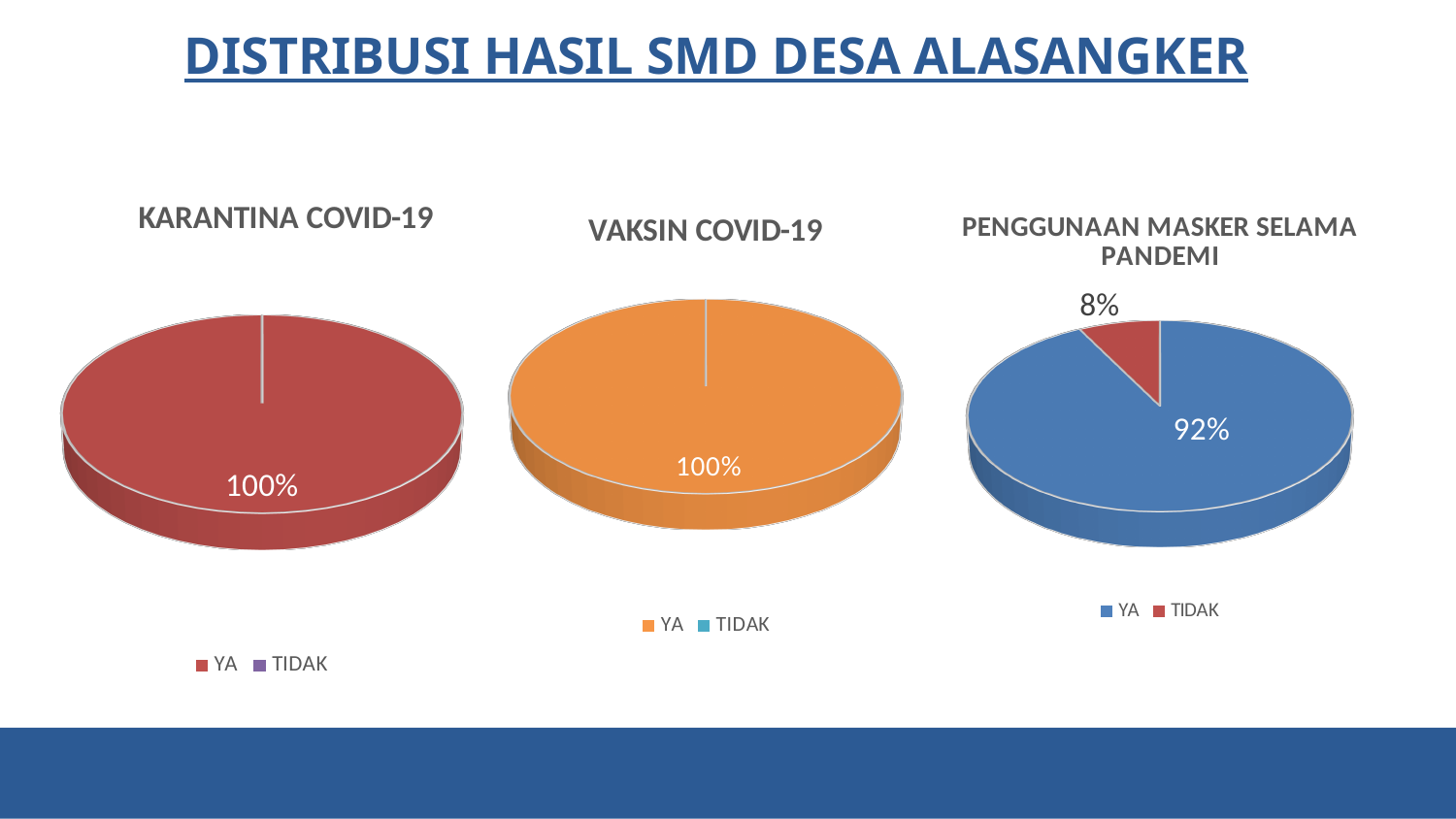
In the PENGGUNAAN MASKER SELAMA PANDEMI chart, what is the difference between the YA and TIDAK shares? 84% In the KARANTINA COVID-19 chart, what share is shown for YA? 100% In the PENGGUNAAN MASKER SELAMA PANDEMI chart, which category has the largest slice? YA In the PENGGUNAAN MASKER SELAMA PANDEMI chart, which is larger, YA or TIDAK? YA What is the title of the chart on the right of the slide? PENGGUNAAN MASKER SELAMA PANDEMI How many entries does the legend of the VAKSIN COVID-19 chart list? 2 What kind of chart is the KARANTINA COVID-19 chart? pie chart In the PENGGUNAAN MASKER SELAMA PANDEMI chart, what share is shown for TIDAK? 8% How many pie charts are on the slide? 3 In the PENGGUNAAN MASKER SELAMA PANDEMI chart, what share is shown for YA? 92% In the VAKSIN COVID-19 chart, what share is shown for YA? 100% In the PENGGUNAAN MASKER SELAMA PANDEMI chart, which category has the smallest slice? TIDAK